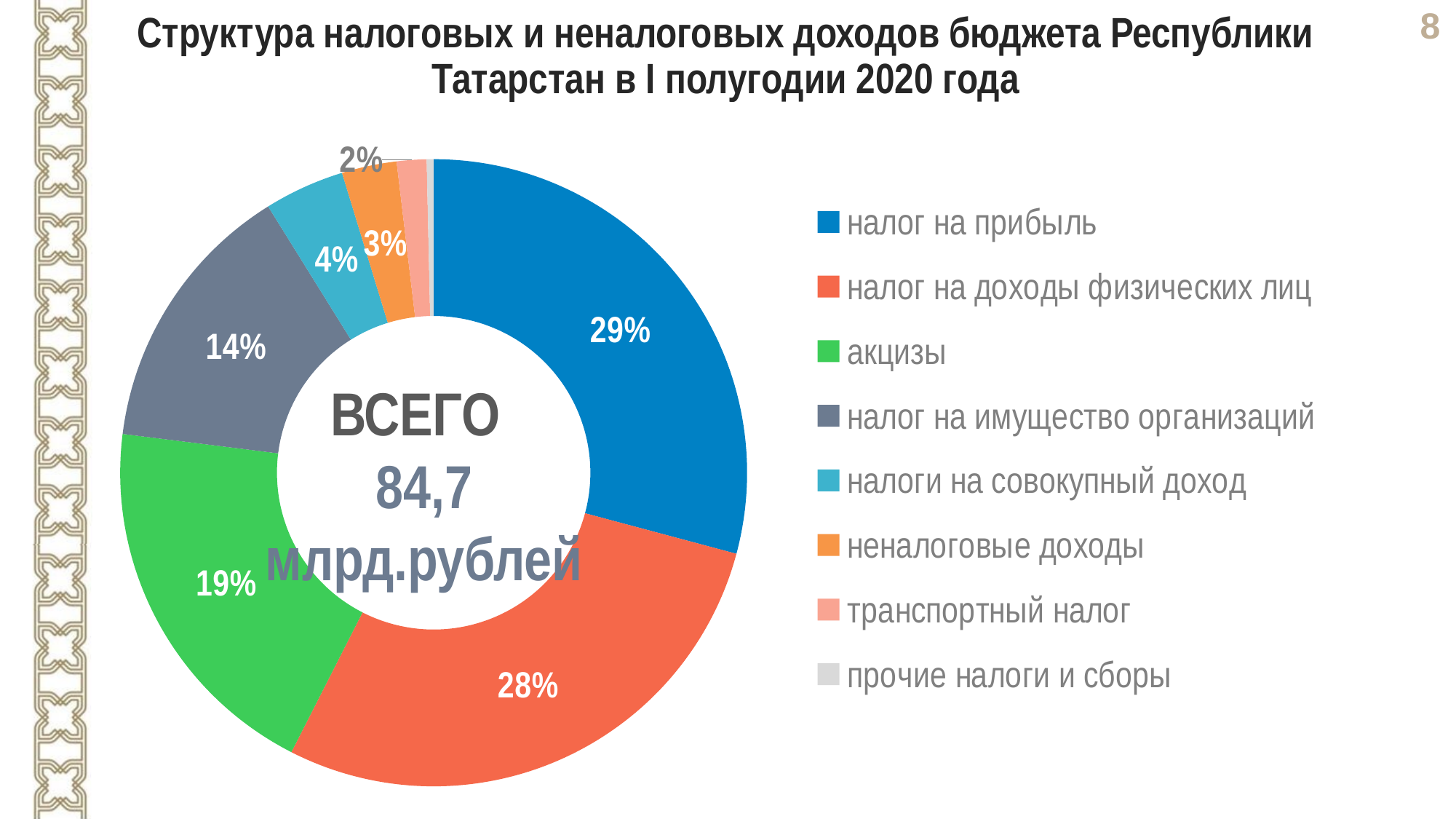
What is the difference in percentage points between акцизы and налог на имущество организаций? 5 percentage points Which is larger: the share of акцизы or the share of налоги на совокупный доход? акцизы What share of the budget revenue is налог на прибыль? 29% What share of the budget revenue is налог на имущество организаций? 14% What share of the budget revenue is налог на доходы физических лиц? 28% What total value is shown in the centre of the chart? 84,7 млрд.рублей What kind of chart is shown on the slide? Doughnut (pie) chart How many categories does the legend list? 8 What share of the budget revenue is акцизы? 19% What share of the budget revenue is налоги на совокупный доход? 4% Which category has the largest share of the budget revenue? налог на прибыль What share of the budget revenue is неналоговые доходы? 3%